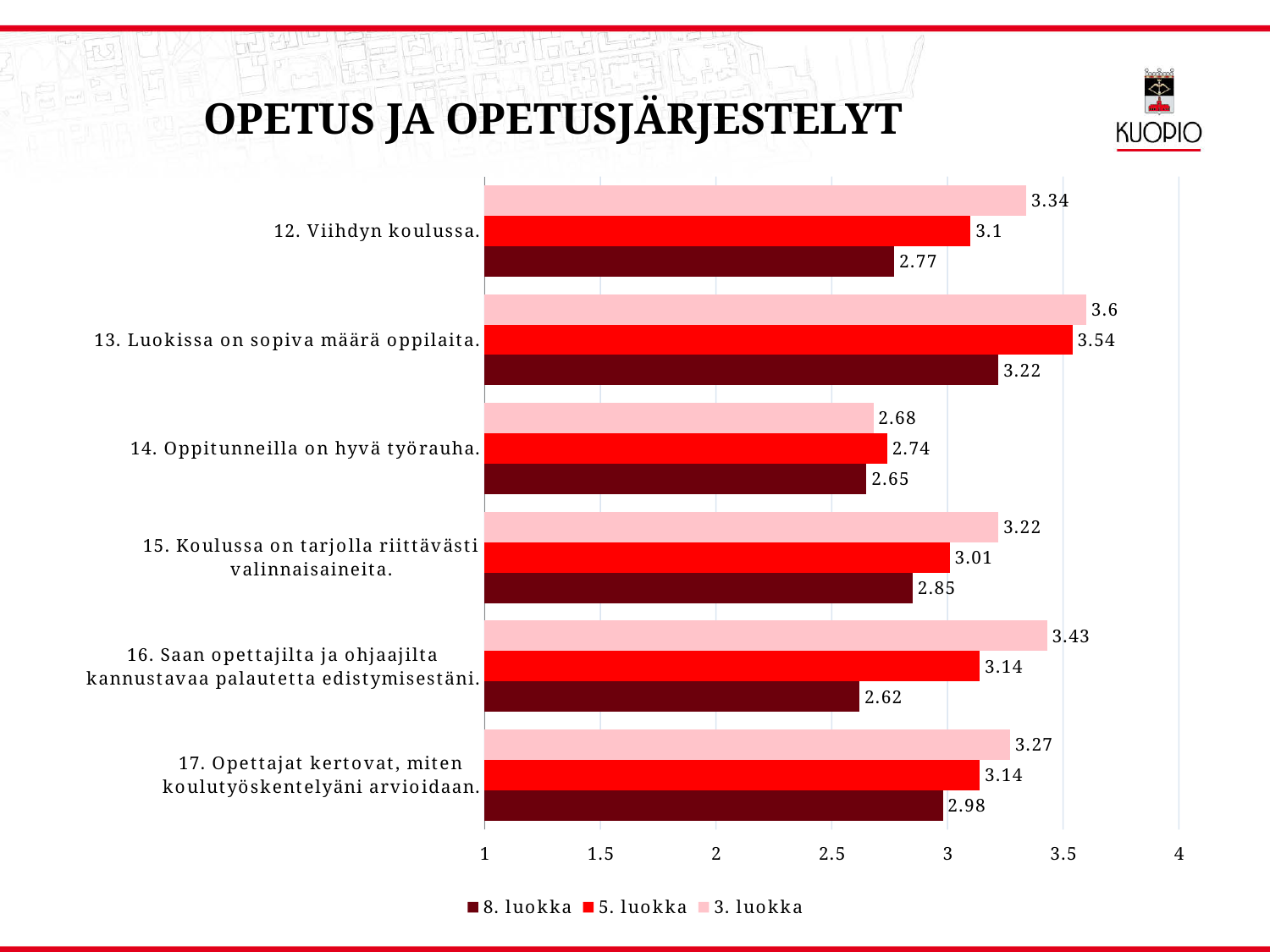
For "14. Oppitunneilla on hyvä työrauha.", which is larger: the 5. luokka value or the 3. luokka value? 5. luokka How many categories (statements) are shown on the chart? 6 What is the value for 8. luokka on "16. Saan opettajilta ja ohjaajilta kannustavaa palautetta edistymisestäni."? 2.62 What is the value for 3. luokka on "13. Luokissa on sopiva määrä oppilaita."? 3.6 Is the 8. luokka value for "17. Opettajat kertovat, miten koulutyöskentelyäni arvioidaan." greater or less than 3? less Which category has the highest value for 3. luokka? 13. Luokissa on sopiva määrä oppilaita. What is the difference between the 3. luokka and 8. luokka values for "12. Viihdyn koulussa."? 0.57 Which series is shown in the darkest colour in the legend? 8. luokka What kind of chart is shown on the slide? bar chart How many series does the legend list? 3 Which category has the lowest value for 8. luokka? 16. Saan opettajilta ja ohjaajilta kannustavaa palautetta edistymisestäni. What is the value for 5. luokka on "14. Oppitunneilla on hyvä työrauha."? 2.74